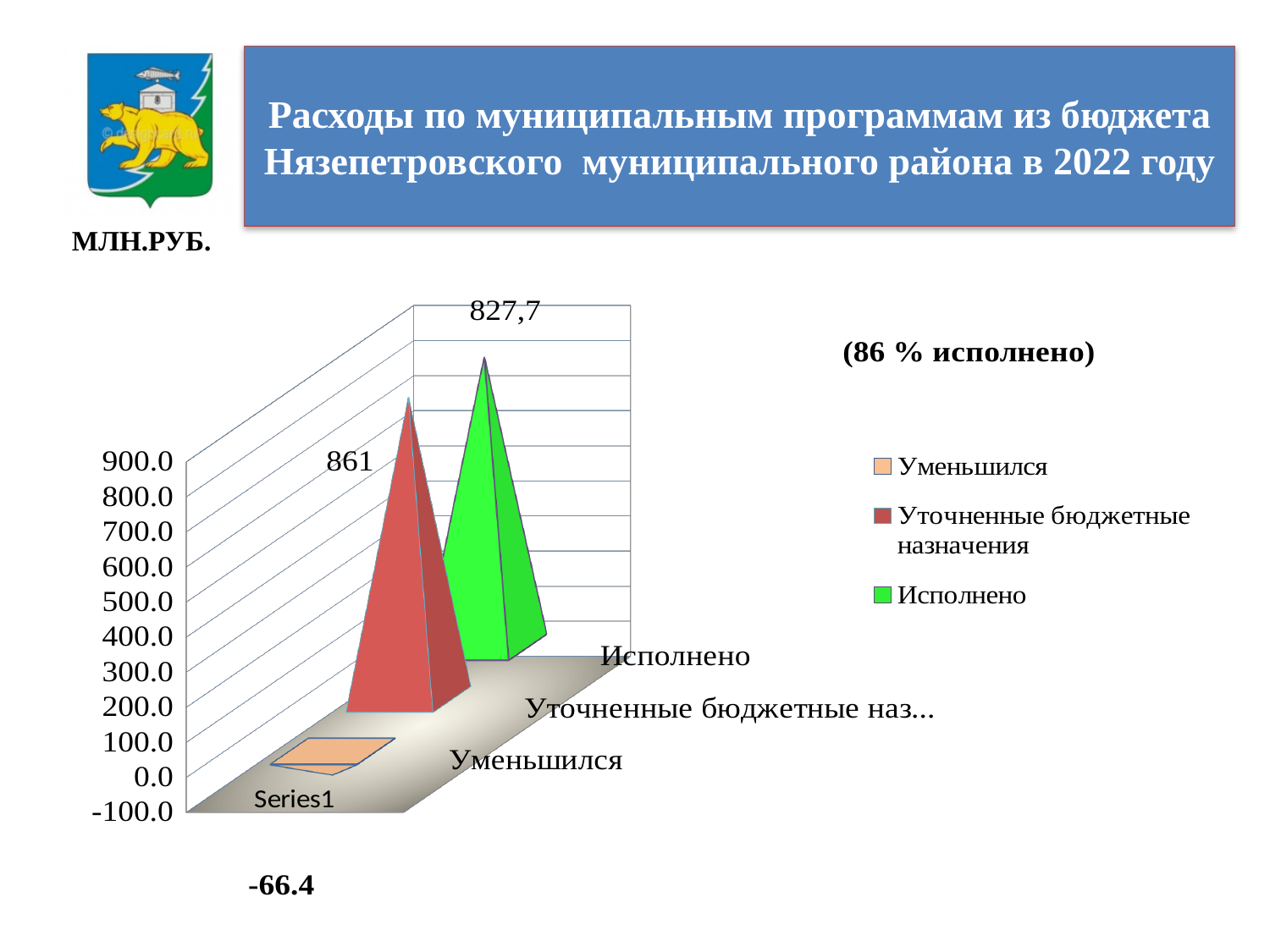
What kind of chart is shown on the slide? bar chart What is the difference between Уточненные бюджетные назначения and Исполнено? 33.3 What value is shown for Уточненные бюджетные назначения? 861 How many entries does the legend list? 3 Which category has the lowest value? Уменьшился Is the value for Исполнено greater or less than 800.0? greater What value is shown for Исполнено? 827,7 How many categories are plotted in the chart? 3 Which is larger, Уточненные бюджетные назначения or Исполнено? Уточненные бюджетные назначения Which category has the highest value? Уточненные бюджетные назначения What percentage of execution is stated next to the chart? 86 % What value is shown for Уменьшился? -66.4